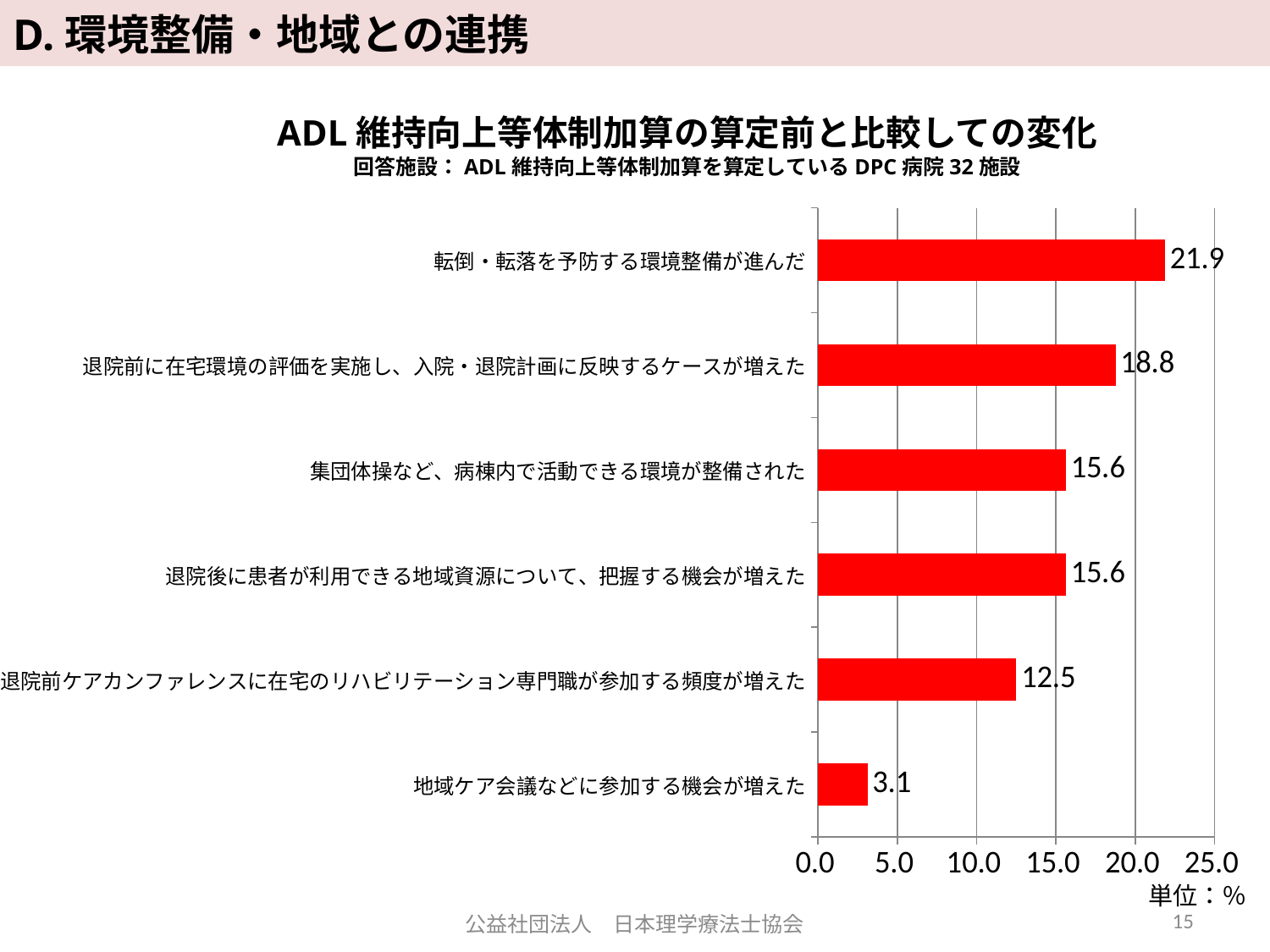
What unit is indicated for the values in the chart? % How many categories are shown in the chart? 6 Which category has the highest value? 転倒・転落を予防する環境整備が進んだ Which category has the lowest value? 地域ケア会議などに参加する機会が増えた What is the difference between the values for 転倒・転落を予防する環境整備が進んだ and 退院前に在宅環境の評価を実施し、入院・退院計画に反映するケースが増えた? 3.1 What is the value for 退院前ケアカンファレンスに在宅のリハビリテーション専門職が参加する頻度が増えた? 12.5 What is the value for 地域ケア会議などに参加する機会が増えた? 3.1 What is the title of the chart? ADL維持向上等体制加算の算定前と比較しての変化 Which is larger: the value for 集団体操など、病棟内で活動できる環境が整備された or the value for 退院前ケアカンファレンスに在宅のリハビリテーション専門職が参加する頻度が増えた? 集団体操など、病棟内で活動できる環境が整備された What is the value for 転倒・転落を予防する環境整備が進んだ? 21.9 What kind of chart is shown on the slide? bar chart Is the value for 退院前に在宅環境の評価を実施し、入院・退院計画に反映するケースが増えた greater or less than 15.0? greater